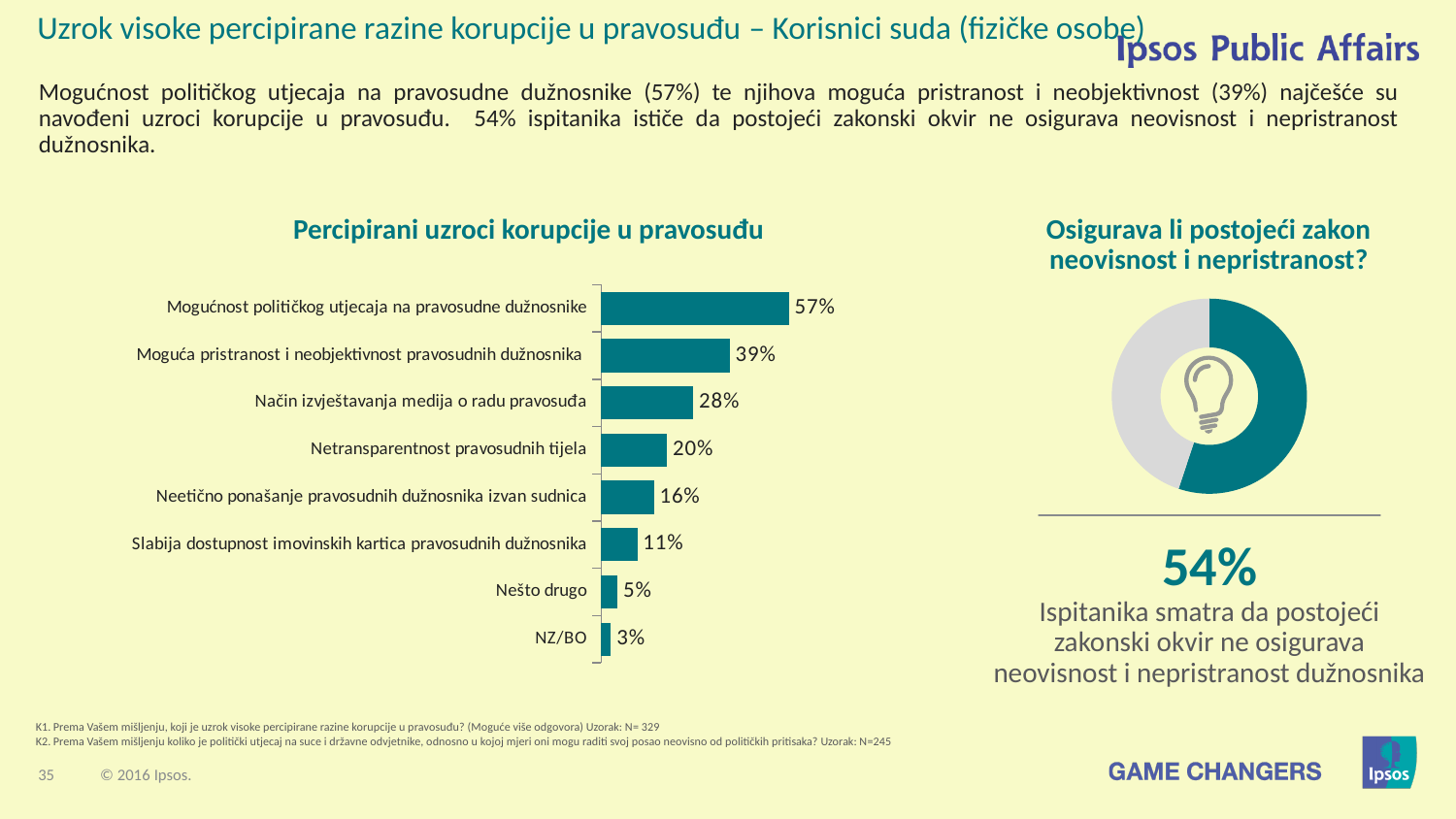
What kind of chart is shown under the title 'Osigurava li postojeći zakon neovisnost i nepristranost?'? Donut chart In the chart 'Percipirani uzroci korupcije u pravosuđu', what is the value for 'Mogućnost političkog utjecaja na pravosudne dužnosnike'? 57% In the chart 'Percipirani uzroci korupcije u pravosuđu', which is larger: 'Nešto drugo' or 'NZ/BO'? Nešto drugo In the chart 'Percipirani uzroci korupcije u pravosuđu', which category has the lowest value? NZ/BO In the chart 'Osigurava li postojeći zakon neovisnost i nepristranost?', what share of respondents think the existing legal framework does not ensure independence and impartiality? 54% In the chart 'Percipirani uzroci korupcije u pravosuđu', what is the value for 'Način izvještavanja medija o radu pravosuđa'? 28% In the chart 'Percipirani uzroci korupcije u pravosuđu', what is the value for 'Slabija dostupnost imovinskih kartica pravosudnih dužnosnika'? 11% In the chart 'Percipirani uzroci korupcije u pravosuđu', what is the difference between 'Mogućnost političkog utjecaja na pravosudne dužnosnike' and 'Moguća pristranost i neobjektivnost pravosudnih dužnosnika'? 18% In the chart 'Percipirani uzroci korupcije u pravosuđu', what is the difference between 'Netransparentnost pravosudnih tijela' and 'Neetično ponašanje pravosudnih dužnosnika izvan sudnica'? 4% In the chart 'Percipirani uzroci korupcije u pravosuđu', which category has the highest value? Mogućnost političkog utjecaja na pravosudne dužnosnike What kind of chart is 'Percipirani uzroci korupcije u pravosuđu'? Bar chart How many categories are shown in the chart 'Percipirani uzroci korupcije u pravosuđu'? 8